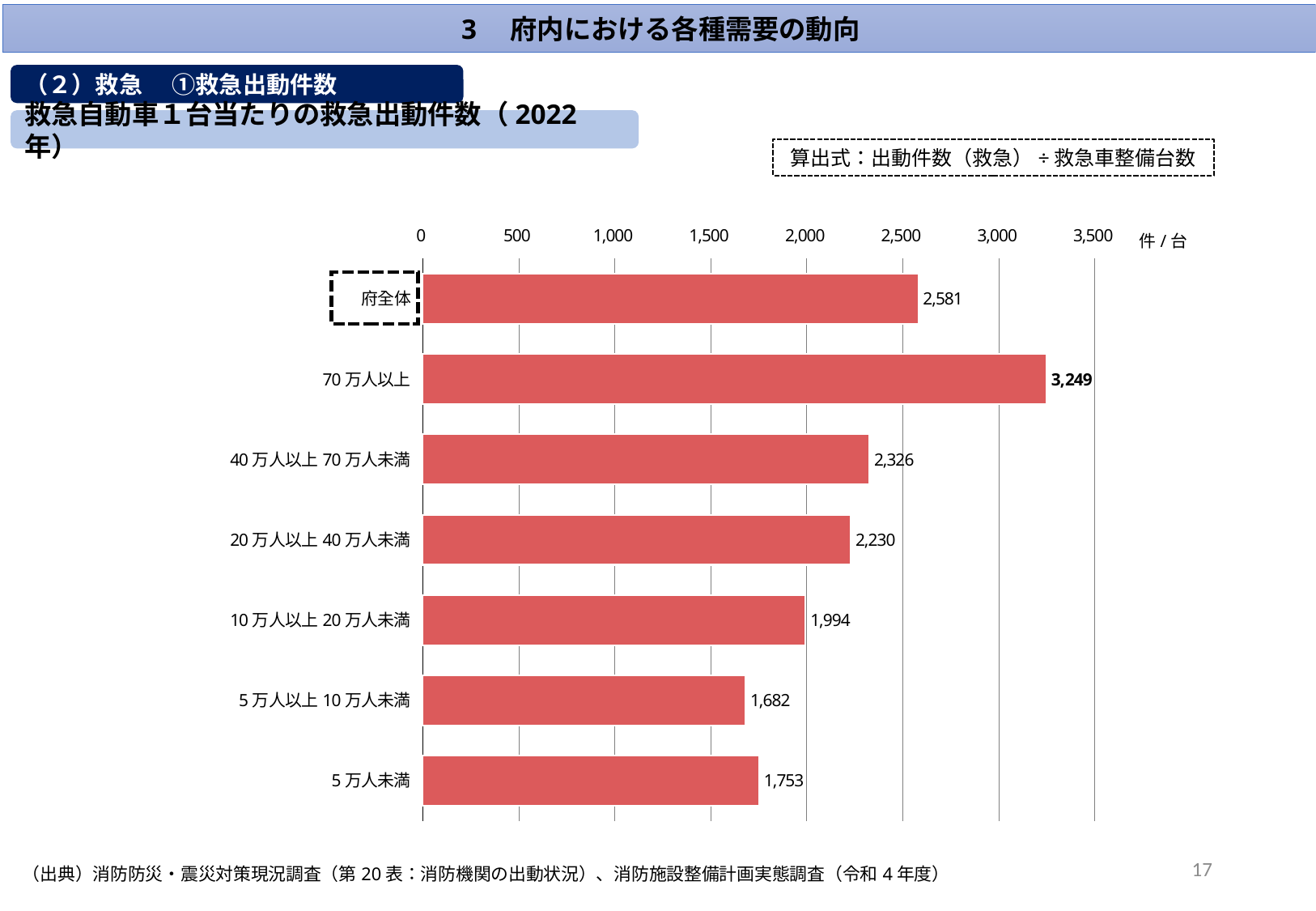
Which category has the highest value? 70万人以上 Is the value for 40万人以上70万人未満 greater or less than 2,000? greater What is the value for 府全体? 2,581 Which is larger, the value for 5万人未満 or the value for 5万人以上10万人未満? 5万人未満 What is the value for 10万人以上20万人未満? 1,994 What is the difference between the values for 70万人以上 and 府全体? 668 How many categories are shown in the chart? 7 Which category has the lowest value? 5万人以上10万人未満 What unit is shown at the end of the horizontal axis? 件/台 What is the value for 70万人以上? 3,249 What kind of chart is shown on the slide? bar chart What is the value for 5万人以上10万人未満? 1,682